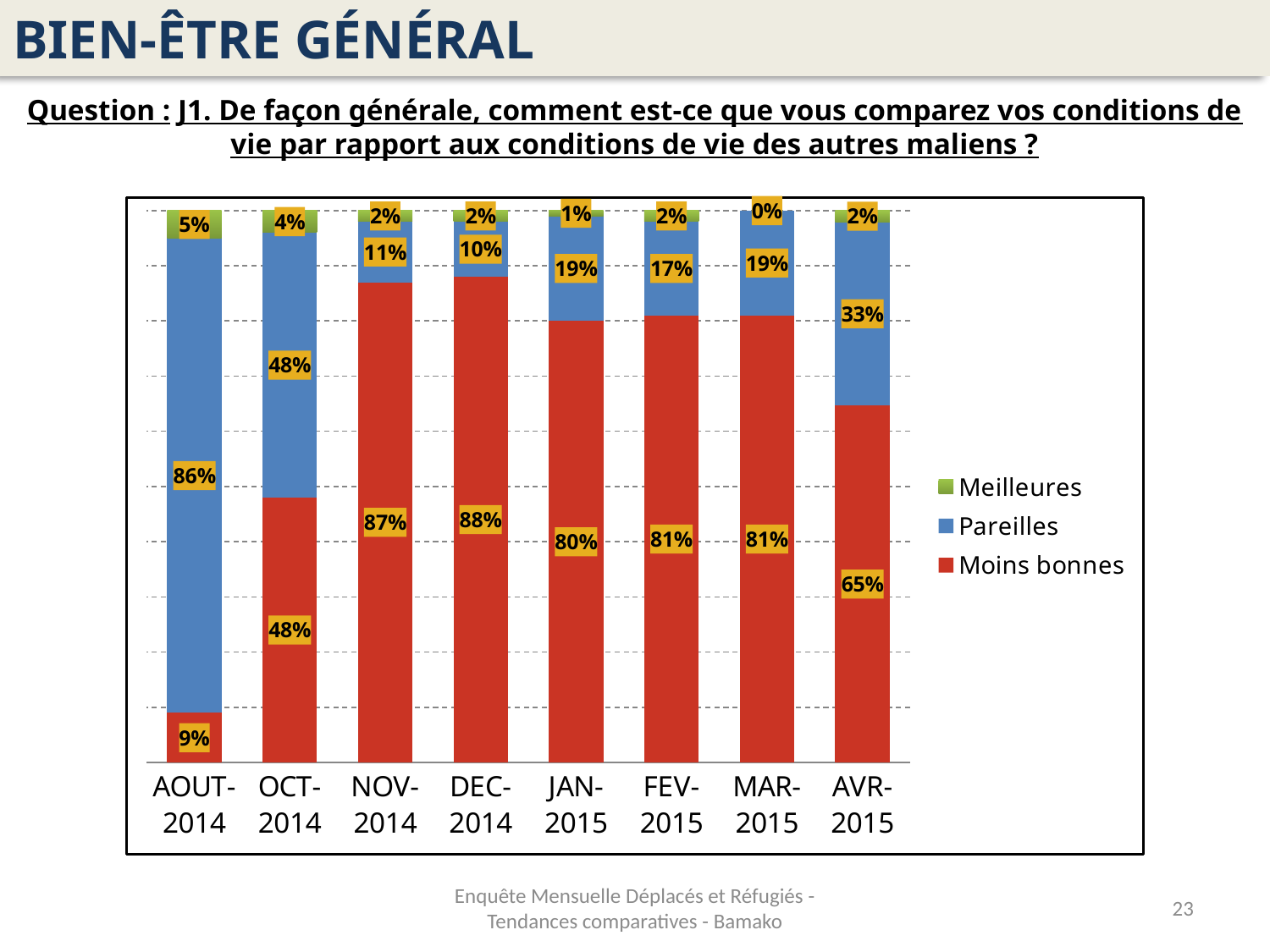
What kind of chart is shown on the slide? Stacked bar chart What is the value for "Pareilles" in AVR-2015? 33% What is the difference between the "Moins bonnes" values for NOV-2014 and AVR-2015? 22% What is the value for "Moins bonnes" in DEC-2014? 88% How many series does the legend list? 3 What is the total of the stacked bar for OCT-2014? 100% In which month is the "Moins bonnes" value lowest? AOUT-2014 Which is larger: the "Pareilles" value for JAN-2015 or for FEV-2015? JAN-2015 What is the value for "Pareilles" in AOUT-2014? 86% In which month is the "Moins bonnes" value highest? DEC-2014 How many months are shown on the x axis? 8 What is the value for "Meilleures" in MAR-2015? 0%